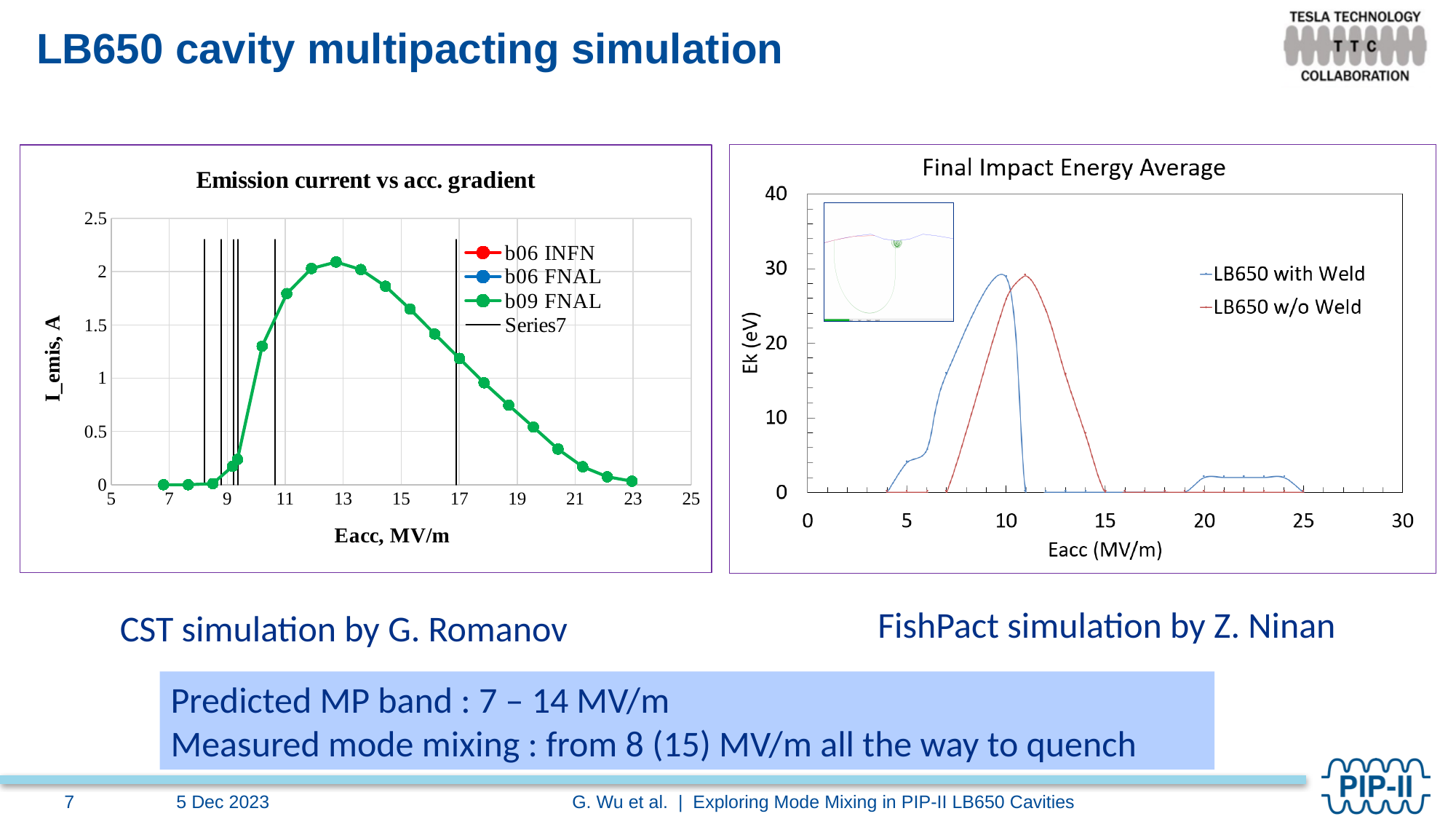
In the 'Final Impact Energy Average' chart, is the LB650 w/o Weld value at Eacc = 11 MV/m greater or less than 20? greater In the 'Emission current vs acc. gradient' chart, is the b09 FNAL value at Eacc = 13 MV/m greater or less than 1.5? greater In the 'Emission current vs acc. gradient' chart, is the b09 FNAL value at Eacc = 21 MV/m greater or less than 0.5? less How many series does the legend of the 'Final Impact Energy Average' chart list? 2 What kind of chart is the 'Emission current vs acc. gradient' chart on the left? line chart What is the y-axis label of the 'Final Impact Energy Average' chart? Ek (eV) What kind of chart is the 'Final Impact Energy Average' chart on the right? line chart In the 'Final Impact Energy Average' chart, which series reaches its peak at a lower Eacc: LB650 with Weld or LB650 w/o Weld? LB650 with Weld In the 'Emission current vs acc. gradient' chart, do the b09 FNAL values rise or fall as Eacc increases from 13 to 23 MV/m? fall How many series does the legend of the 'Emission current vs acc. gradient' chart list? 4